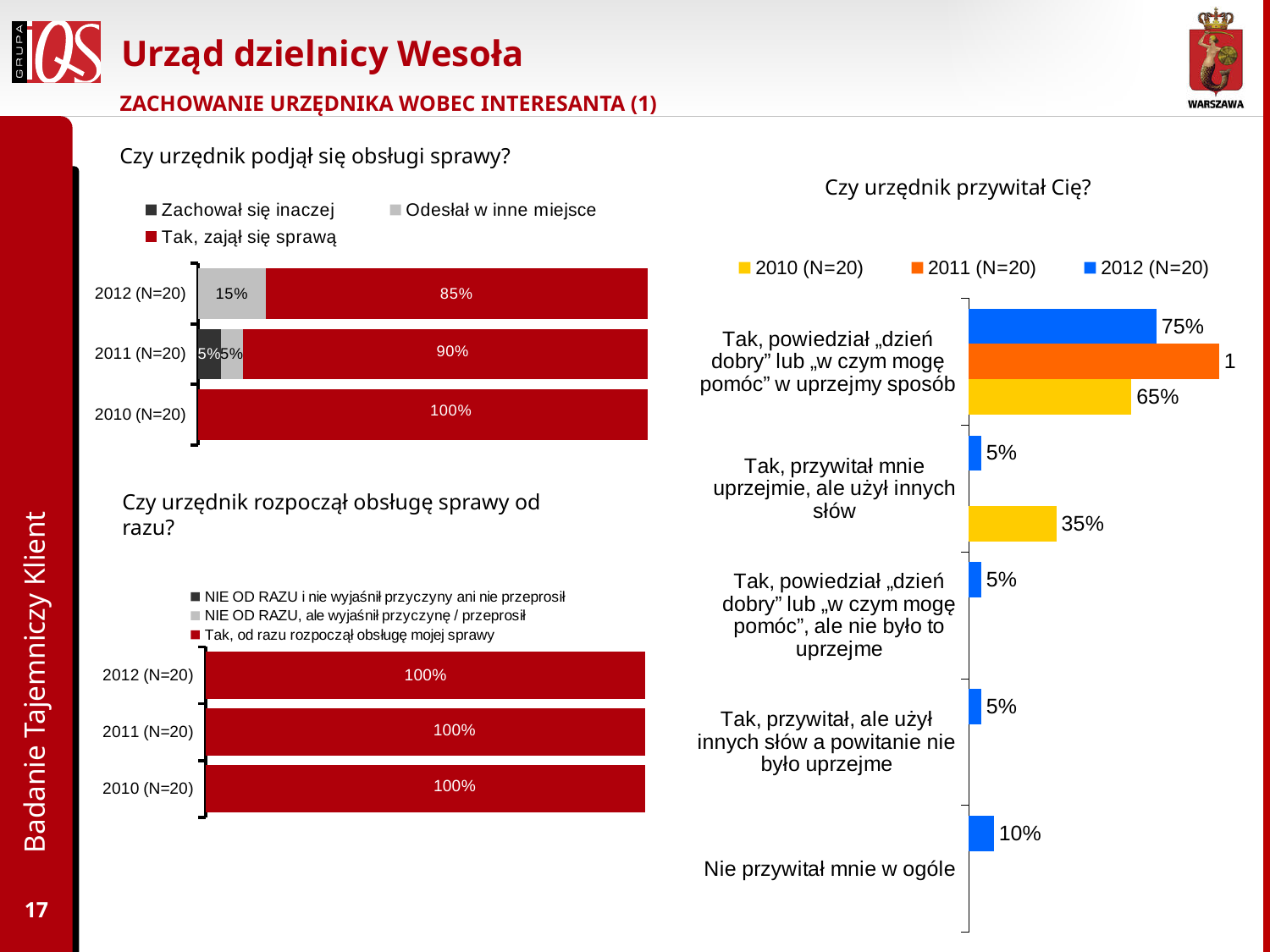
In the chart 'Czy urzędnik przywitał Cię?', what is the difference between the 2012 (N=20) and 2010 (N=20) values for 'Tak, powiedział „dzień dobry” lub „w czym mogę pomóc” w uprzejmy sposób'? 10% In the chart 'Czy urzędnik rozpoczął obsługę sprawy od razu?', what is the value of 'Tak, od razu rozpoczął obsługę mojej sprawy' for 2011 (N=20)? 100% In the chart 'Czy urzędnik podjął się obsługi sprawy?', what is the value of 'Tak, zajął się sprawą' for 2012 (N=20)? 85% In the chart 'Czy urzędnik przywitał Cię?', what is the 2012 (N=20) value for 'Tak, powiedział „dzień dobry” lub „w czym mogę pomóc” w uprzejmy sposób'? 75% In the chart 'Czy urzędnik przywitał Cię?', what is the 2012 (N=20) value for 'Nie przywitał mnie w ogóle'? 10% In the chart 'Czy urzędnik podjął się obsługi sprawy?', how many series does the legend list? 3 What kind of chart is 'Czy urzędnik przywitał Cię?'? Bar chart In the chart 'Czy urzędnik przywitał Cię?', what is the 2010 (N=20) value for 'Tak, przywitał mnie uprzejmie, ale użył innych słów'? 35% In the chart 'Czy urzędnik podjął się obsługi sprawy?', what is the value of 'Tak, zajął się sprawą' for 2011 (N=20)? 90% In the chart 'Czy urzędnik podjął się obsługi sprawy?', which year has the highest value for 'Tak, zajął się sprawą'? 2010 (N=20) In the chart 'Czy urzędnik podjął się obsługi sprawy?', what is the value of 'Odesłał w inne miejsce' for 2012 (N=20)? 15% In the chart 'Czy urzędnik rozpoczął obsługę sprawy od razu?', how many year categories are shown? 3